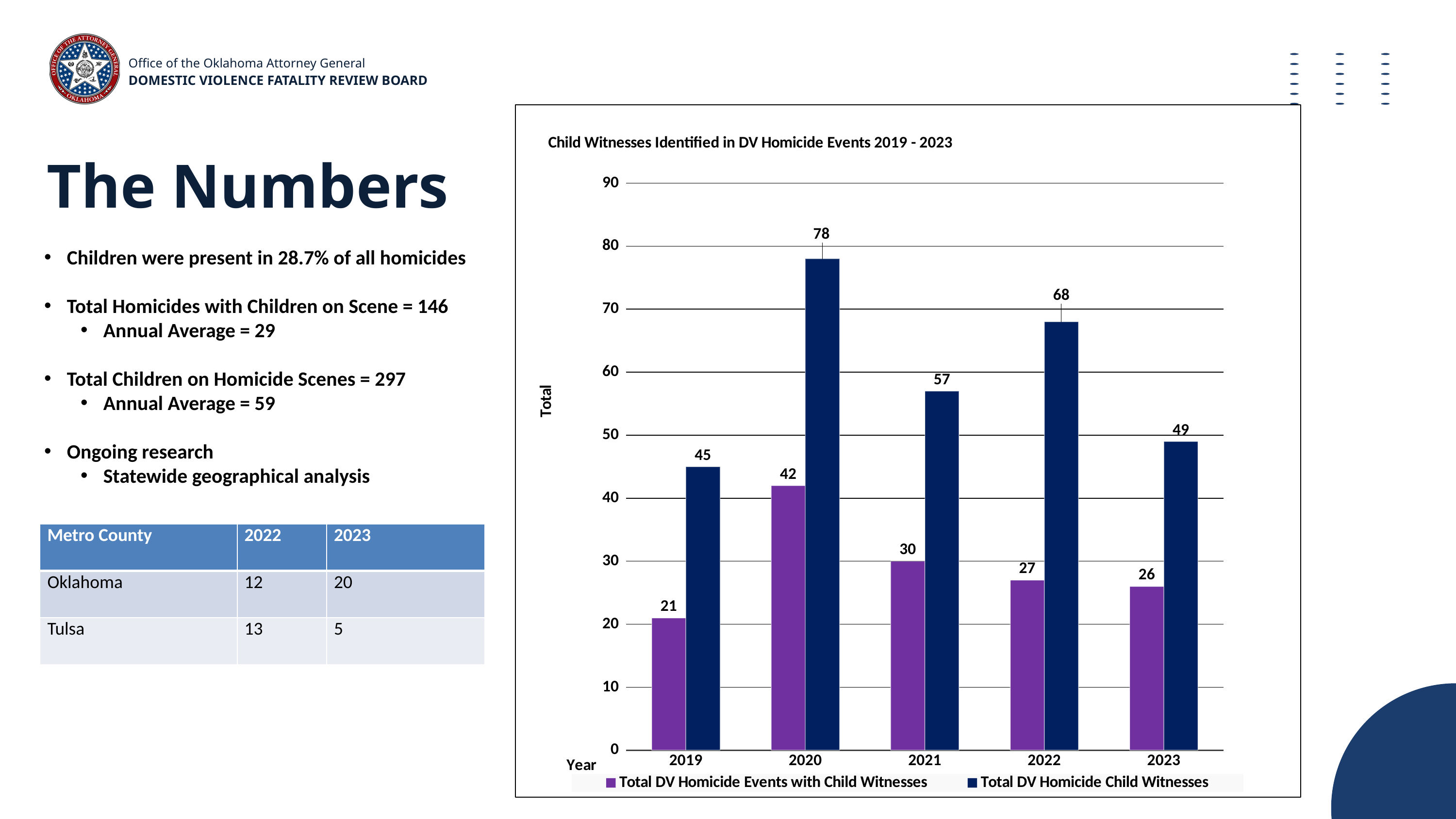
Is the value for Total DV Homicide Child Witnesses in 2021 greater or less than 50? greater How many years are shown on the x axis of the chart? 5 What is the difference between Total DV Homicide Child Witnesses and Total DV Homicide Events with Child Witnesses in 2022? 41 What is the value for Total DV Homicide Child Witnesses in 2023? 49 What kind of chart is shown on the slide? bar chart How many series does the chart legend list? 2 Which is larger: Total DV Homicide Events with Child Witnesses in 2021 or in 2023? 2021 Which year has the highest value for Total DV Homicide Child Witnesses? 2020 What is the value for Total DV Homicide Events with Child Witnesses in 2019? 21 What is the title of the chart? Child Witnesses Identified in DV Homicide Events 2019 - 2023 Which year has the lowest value for Total DV Homicide Events with Child Witnesses? 2019 What is the value for Total DV Homicide Child Witnesses in 2020? 78